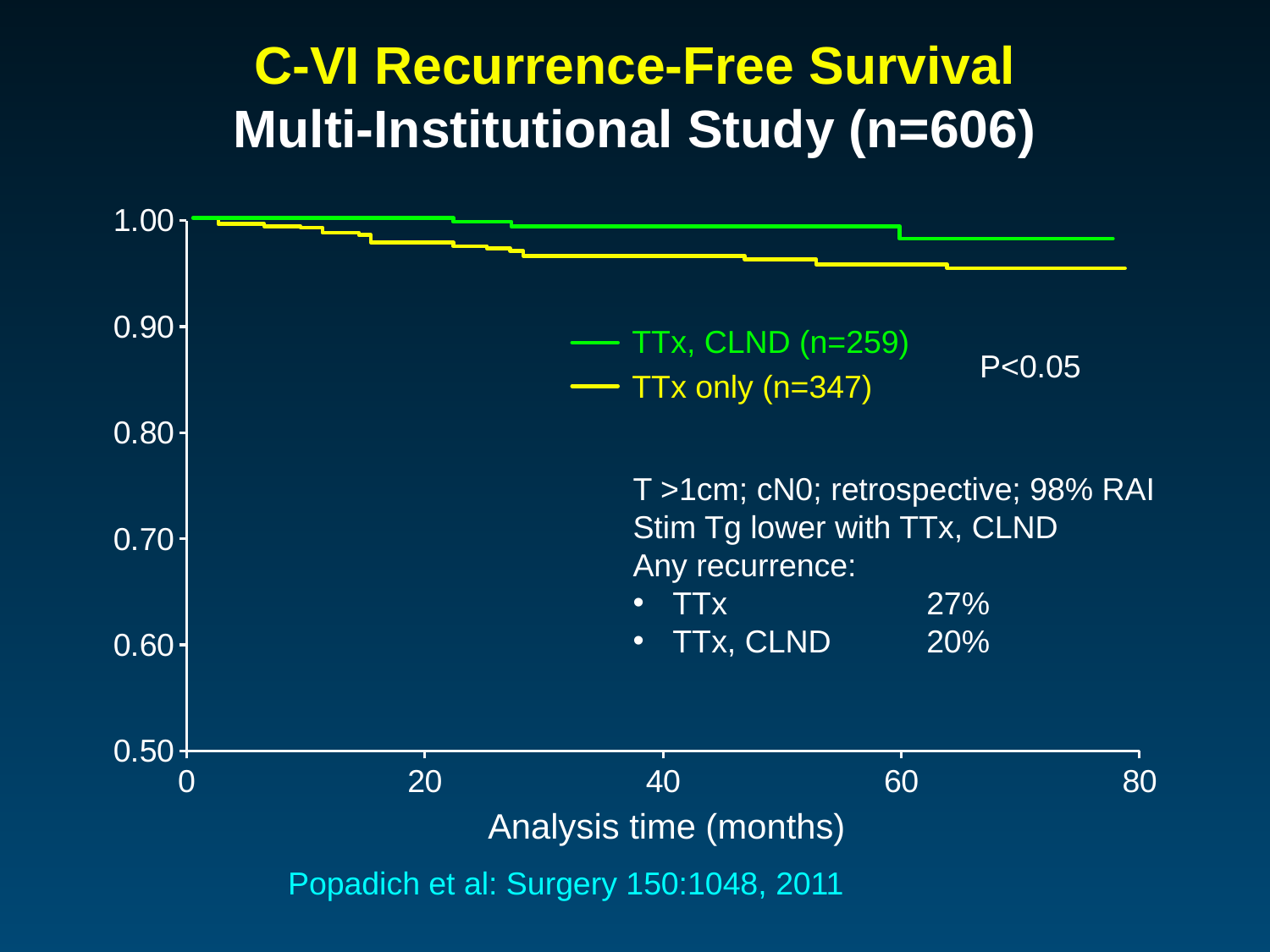
What is the label of the x axis? Analysis time (months) What are the two series named in the legend? TTx, CLND (n=259) and TTx only (n=347) Which series has the lowest recurrence-free survival at 80 months? TTx only How many series does the legend list? 2 Which series stays highest across the whole analysis time? TTx, CLND Do the survival curves rise or fall as analysis time increases? fall Is the value for TTx only at 80 months greater or less than 0.90? greater What kind of chart is shown on the slide? line chart Which series has the higher recurrence-free survival at 60 months, TTx, CLND or TTx only? TTx, CLND Is the value for TTx only at 20 months greater or less than 0.80? greater What is the n shown in the legend for the TTx only series? 347 Is the value for TTx, CLND at 40 months greater or less than 0.90? greater